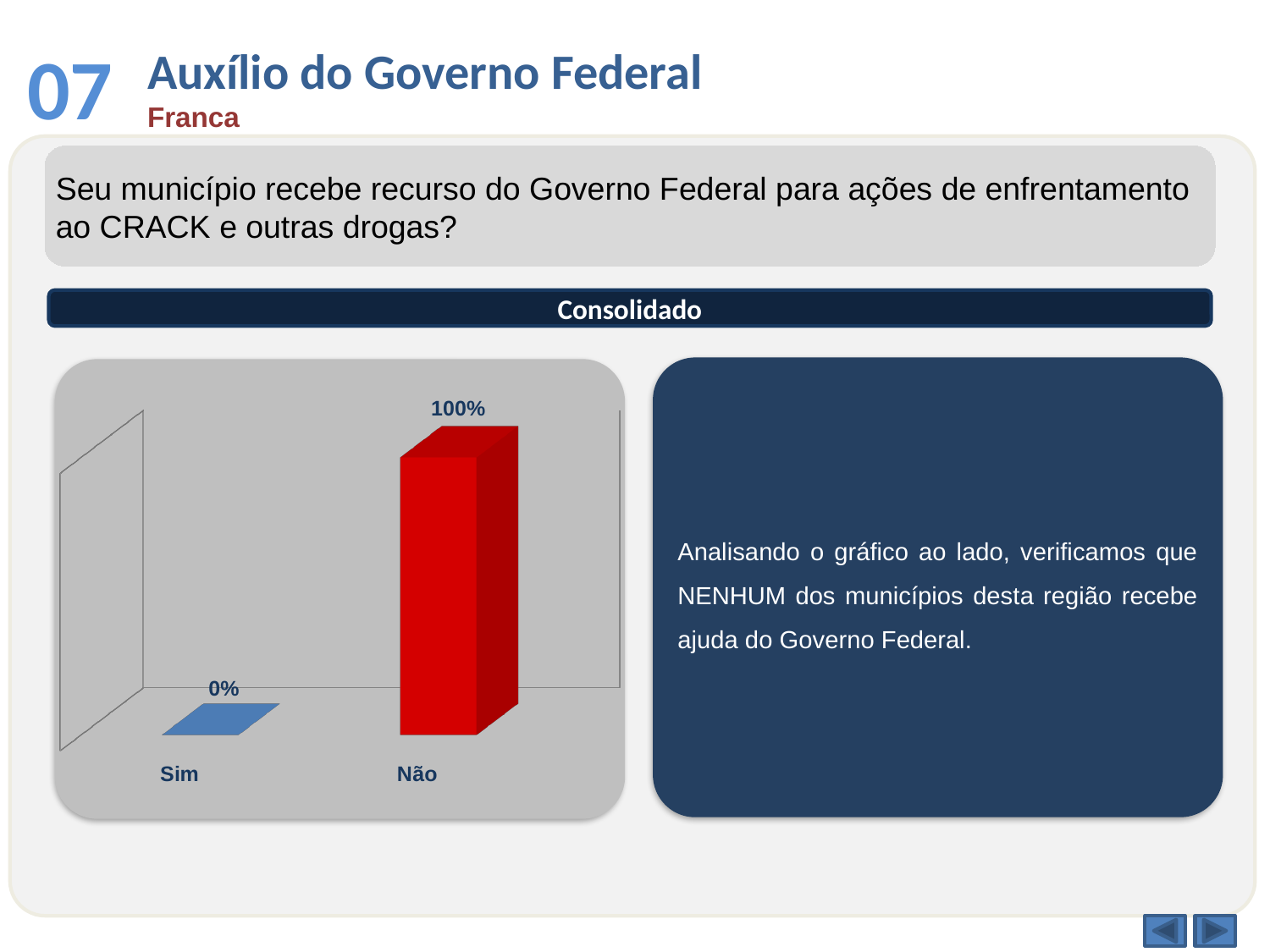
Which category has the highest value? Não What colour is the bar for Não? red What is the value for Sim? 0% What kind of chart is shown on the slide? bar chart Which is larger, the value for Sim or the value for Não? Não What is the difference between the values for Não and Sim? 100% How many categories are shown in the chart? 2 What is the total of the values for Sim and Não? 100% Which category has the lowest value? Sim What colour is the bar for Sim? blue What is the value for Não? 100%